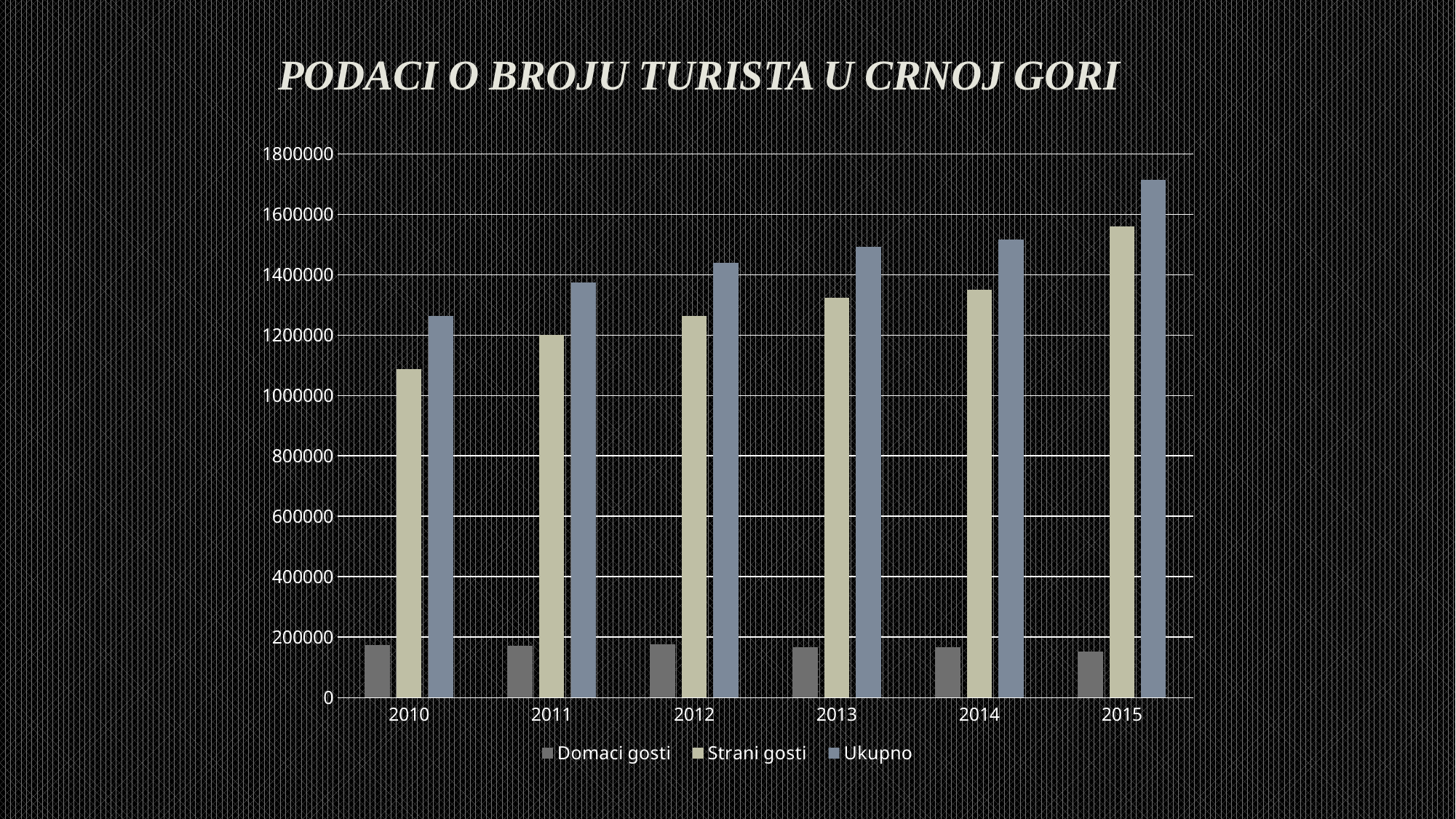
In which year is the Strani gosti value lowest? 2010 In which year is the Ukupno value highest? 2015 Is the Strani gosti value for 2010 greater or less than 1200000? less How many years are shown on the x axis? 6 In which year is the Domaci gosti value lowest? 2015 How many series does the legend list? 3 Do the Ukupno values rise or fall from 2010 to 2015? rise Is the Ukupno value for 2015 greater or less than 1600000? greater What is the title of the chart? PODACI O BROJU TURISTA U CRNOJ GORI Is the Domaci gosti value for 2013 greater or less than 200000? less Which is larger: the Strani gosti value for 2015 or the Ukupno value for 2010? Strani gosti for 2015 What kind of chart is shown on the slide? bar chart